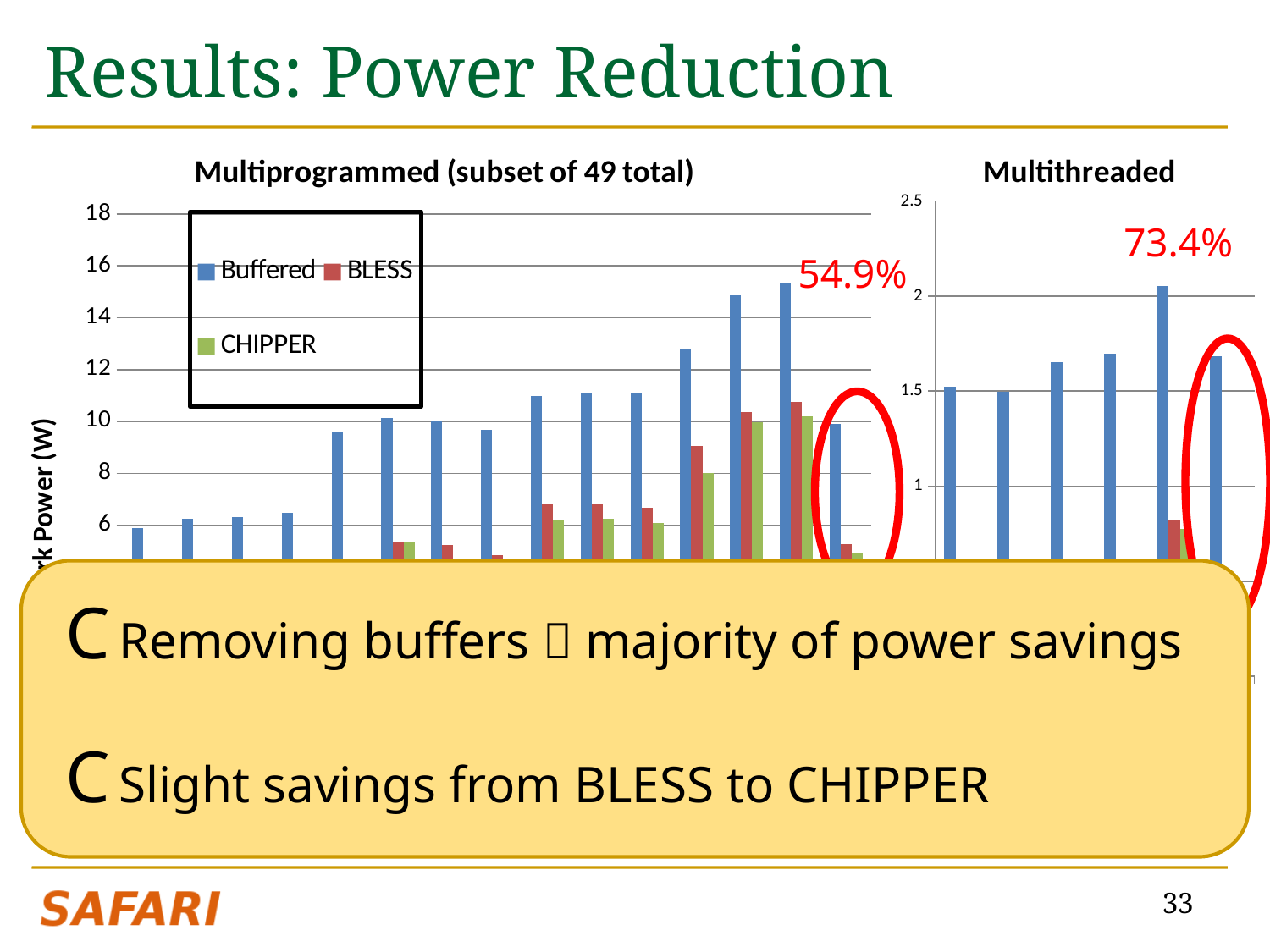
In the Multithreaded chart, is the value of the tallest Buffered bar greater or less than 1.5? greater In the Multiprogrammed chart, is the value of the tallest Buffered bar greater or less than 14? greater What kind of chart is the Multiprogrammed (subset of 49 total) chart? bar chart How many series does the legend of the Multiprogrammed chart list? 3 In the Multiprogrammed chart, is the value of the leftmost Buffered bar greater or less than 8? less What kind of chart is the Multithreaded chart? bar chart What percentage annotation is shown on the Multithreaded chart? 73.4% In the Multiprogrammed chart, which series has the tallest bars overall? Buffered What percentage annotation is shown on the Multiprogrammed chart? 54.9%